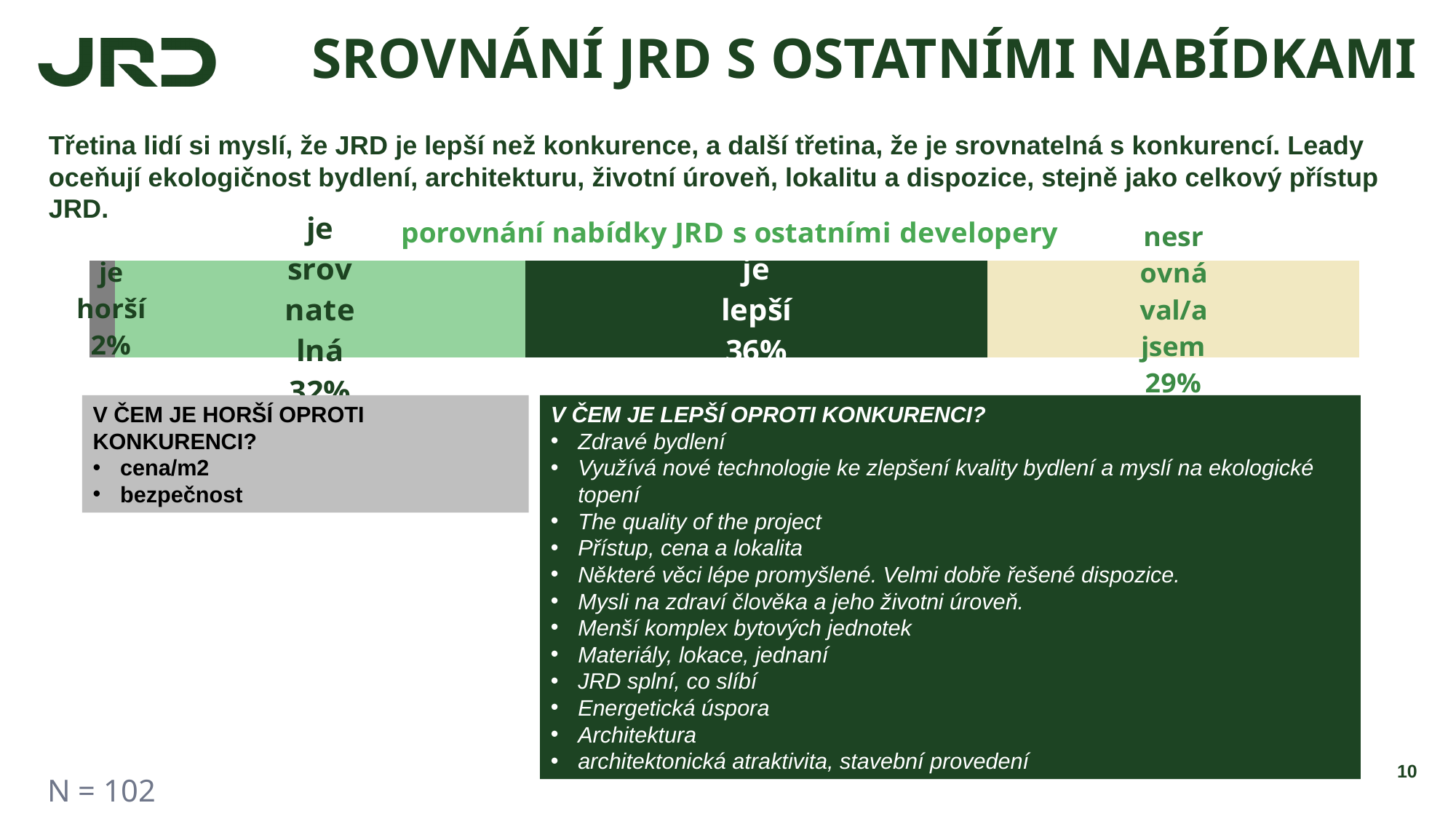
What colour is the 'je lepší' segment of the bar? dark green What percentage of respondents said JRD is 'je srovnatelná' (comparable)? 32% Which segment of the bar has the highest value? je lepší Which segment of the bar has the lowest value? je horší What kind of chart is shown on the slide? stacked bar chart Which is larger: the share for 'je srovnatelná' or the share for 'nesrovnával/a jsem'? je srovnatelná What is the difference between the 'je lepší' and 'je srovnatelná' shares? 4 percentage points What percentage of respondents said JRD is 'je lepší' (better)? 36% How many segments does the stacked bar contain? 4 What percentage of respondents answered 'nesrovnával/a jsem' (did not compare)? 29% What percentage of respondents said JRD is 'je horší' (worse)? 2% What is the title of the chart on the slide? porovnání nabídky JRD s ostatními developery